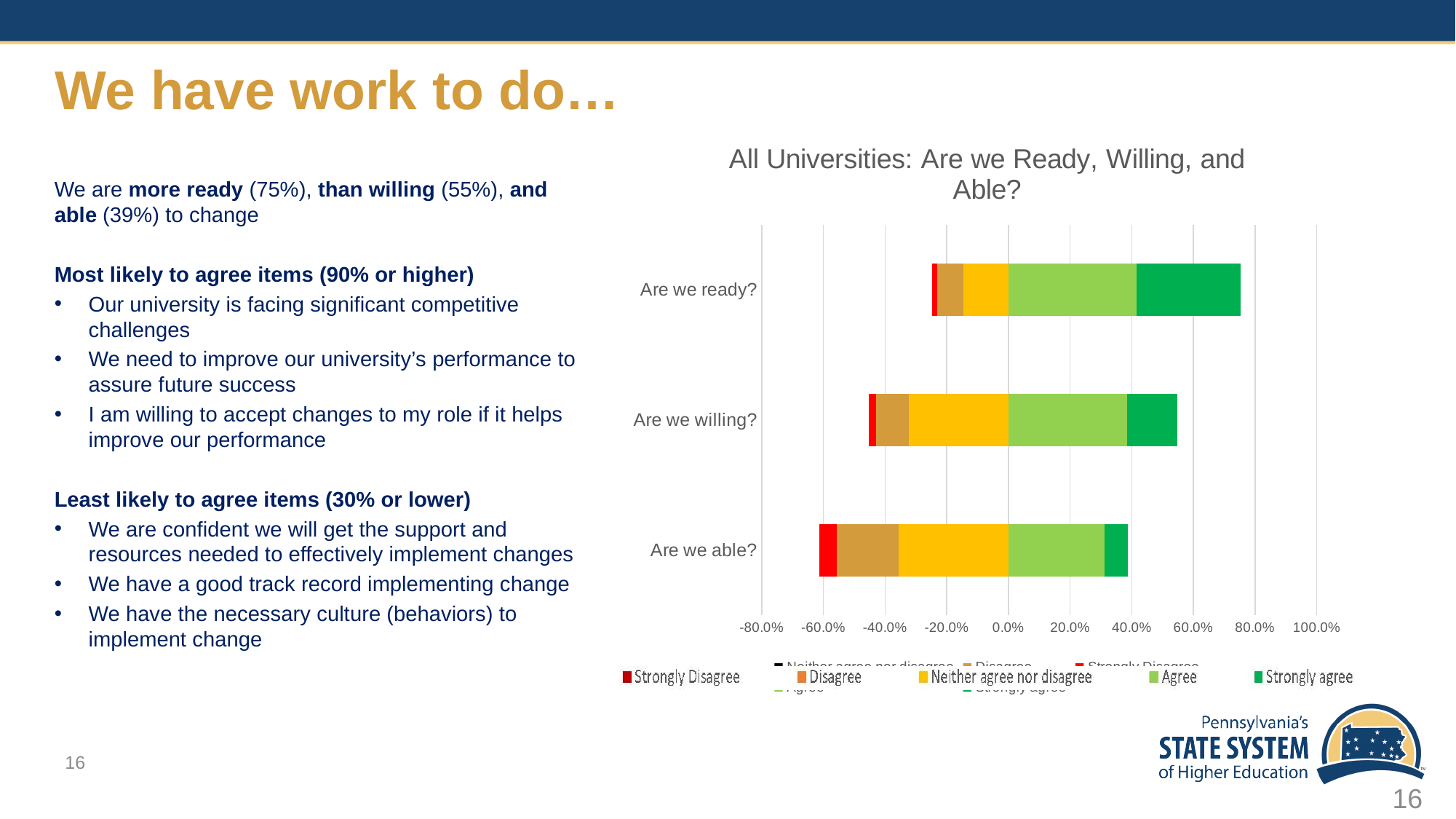
How many series does the chart legend list? 5 How many categories (questions) are plotted on the chart? 3 Which category has the largest Disagree segment? Are we able? Which colour represents the Neither agree nor disagree series in the chart? yellow What type of chart is shown on the slide? bar chart Which category has the largest Strongly agree segment? Are we ready? What is the title of the chart? All Universities: Are we Ready, Willing, and Able? Which category has the smallest Neither agree nor disagree segment? Are we ready? Which category has the largest Strongly Disagree segment? Are we able? Which has a larger Agree segment, 'Are we ready?' or 'Are we able?'? Are we ready? Is the right end of the bar for 'Are we willing?' greater or less than 60.0%? less Is the right end of the bar for 'Are we ready?' greater or less than 60.0%? greater